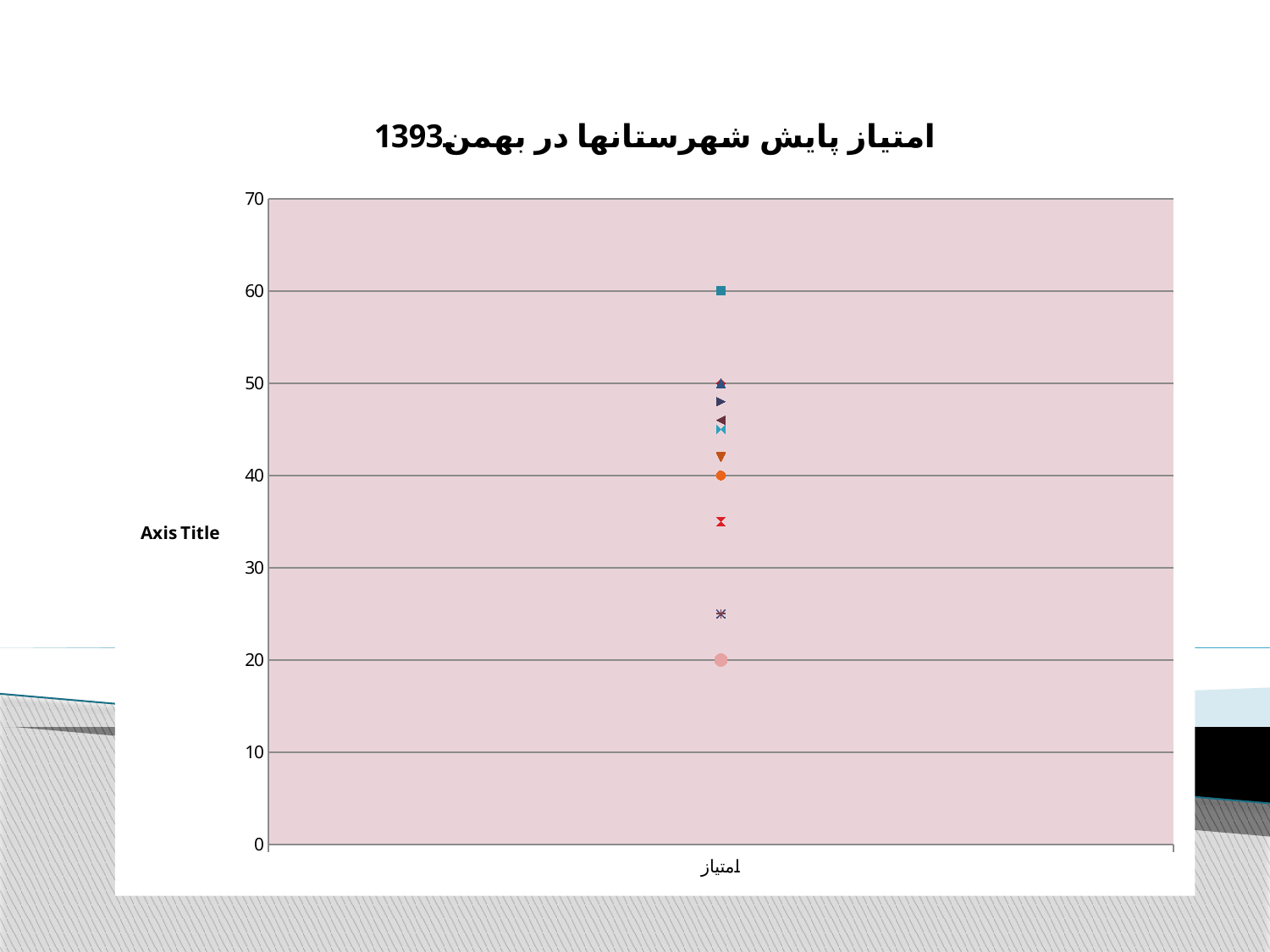
What is the label shown on the vertical axis of the chart? Axis Title What is the lowest value plotted on the chart? 20 What is the title of the chart? امتیاز پایش شهرستانها در بهمن1393 Is the lowest plotted value on the chart greater or less than 30? less Is the highest plotted value on the chart greater or less than 50? greater What is the maximum value shown on the vertical axis of the chart? 70 What is the highest value plotted on the chart? 60 What is the difference between the highest and lowest plotted values on the chart? 40 How many categories are shown on the horizontal axis of the chart? 1